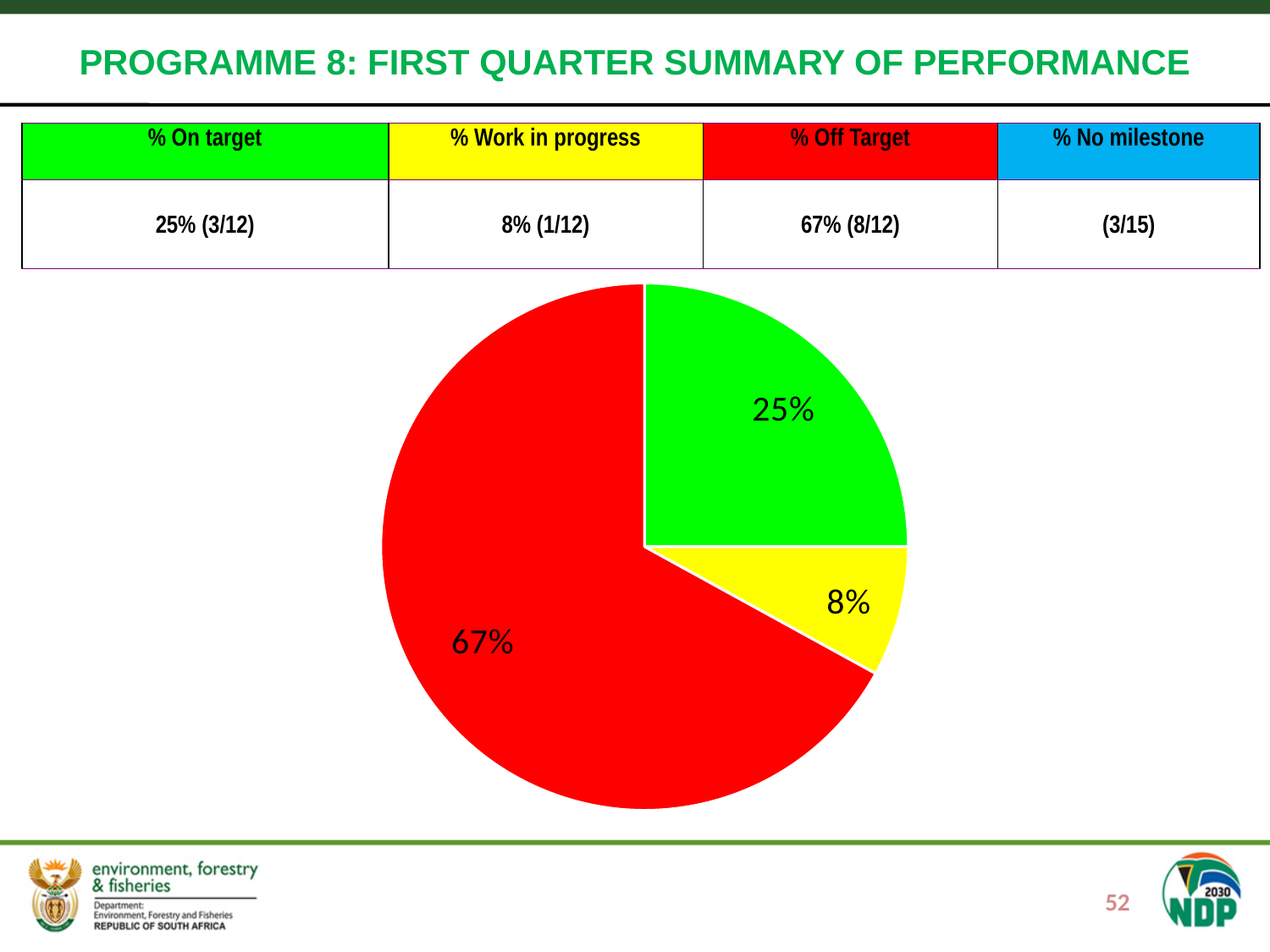
What is the title of the slide containing the pie chart? PROGRAMME 8: FIRST QUARTER SUMMARY OF PERFORMANCE What kind of chart is shown on the slide? pie chart What percentage is shown on the red slice of the pie chart? 67% Which colour represents the On target category in the pie chart? green How many slices does the pie chart have? 3 What percentage is shown on the yellow slice of the pie chart? 8% What is the difference between the red slice and the green slice of the pie chart? 42% Which slice of the pie chart is the largest? 67% (red, Off Target) Which slice of the pie chart is the smallest? 8% (yellow, Work in progress) Which is larger in the pie chart, the green slice or the yellow slice? the green slice (25%) What share of the pie does the Off Target category take? 67% What percentage is shown on the green slice of the pie chart? 25%